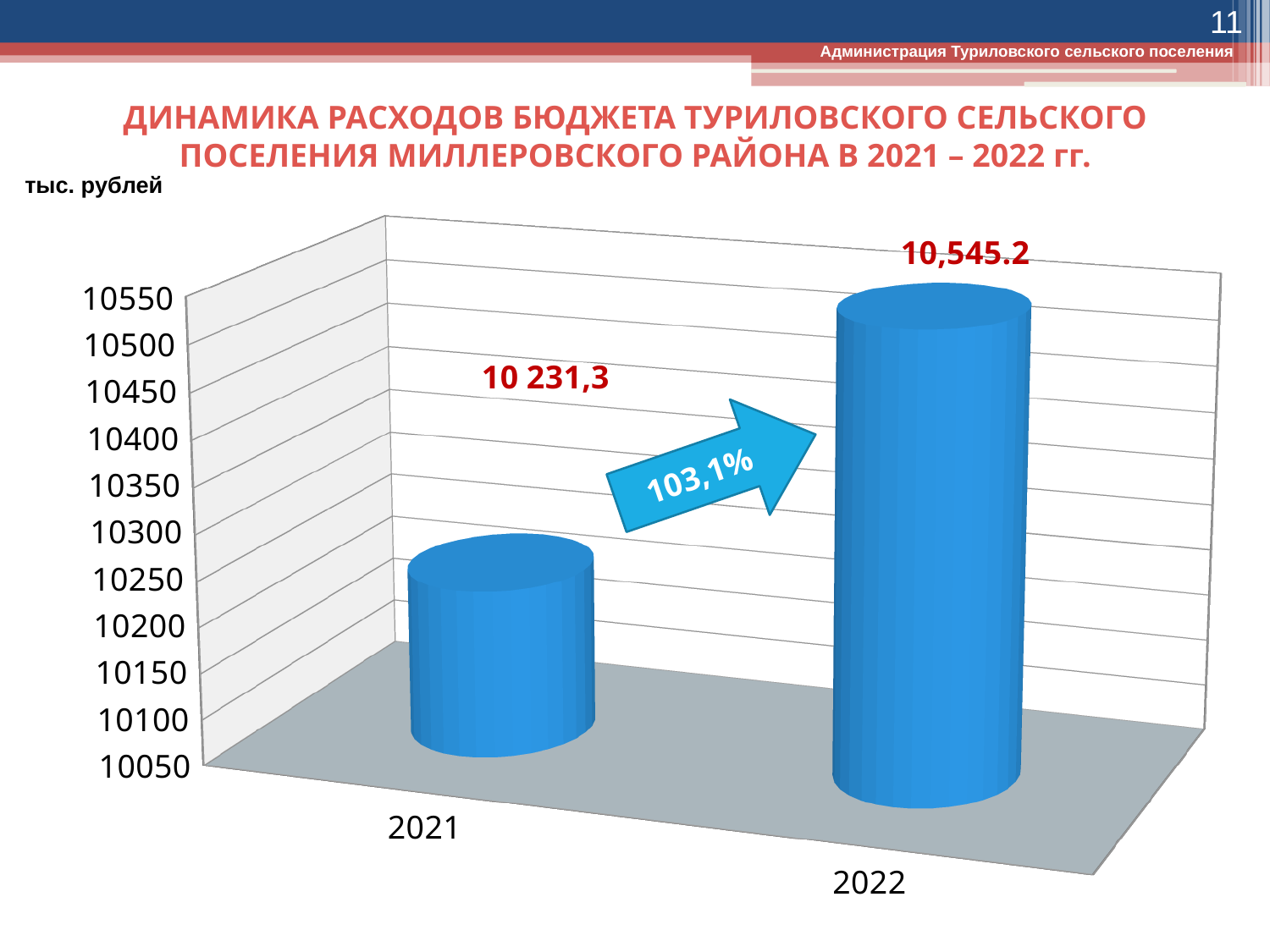
How many years are shown on the chart? 2 Is the value for 2022 larger than the value for 2021? Yes What percentage is written on the arrow between the two bars? 103,1% What is the value for 2022? 10,545.2 Which year has the lower value? 2021 Is the value for 2022 greater or less than 10400? greater Which year has the higher value? 2022 What kind of chart is shown on the slide? Bar chart By how much does the 2022 value exceed the 2021 value? 313.9 Do the values rise or fall from 2021 to 2022? Rise What is the value for 2021? 10 231,3 Is the value for 2021 greater or less than 10400? less